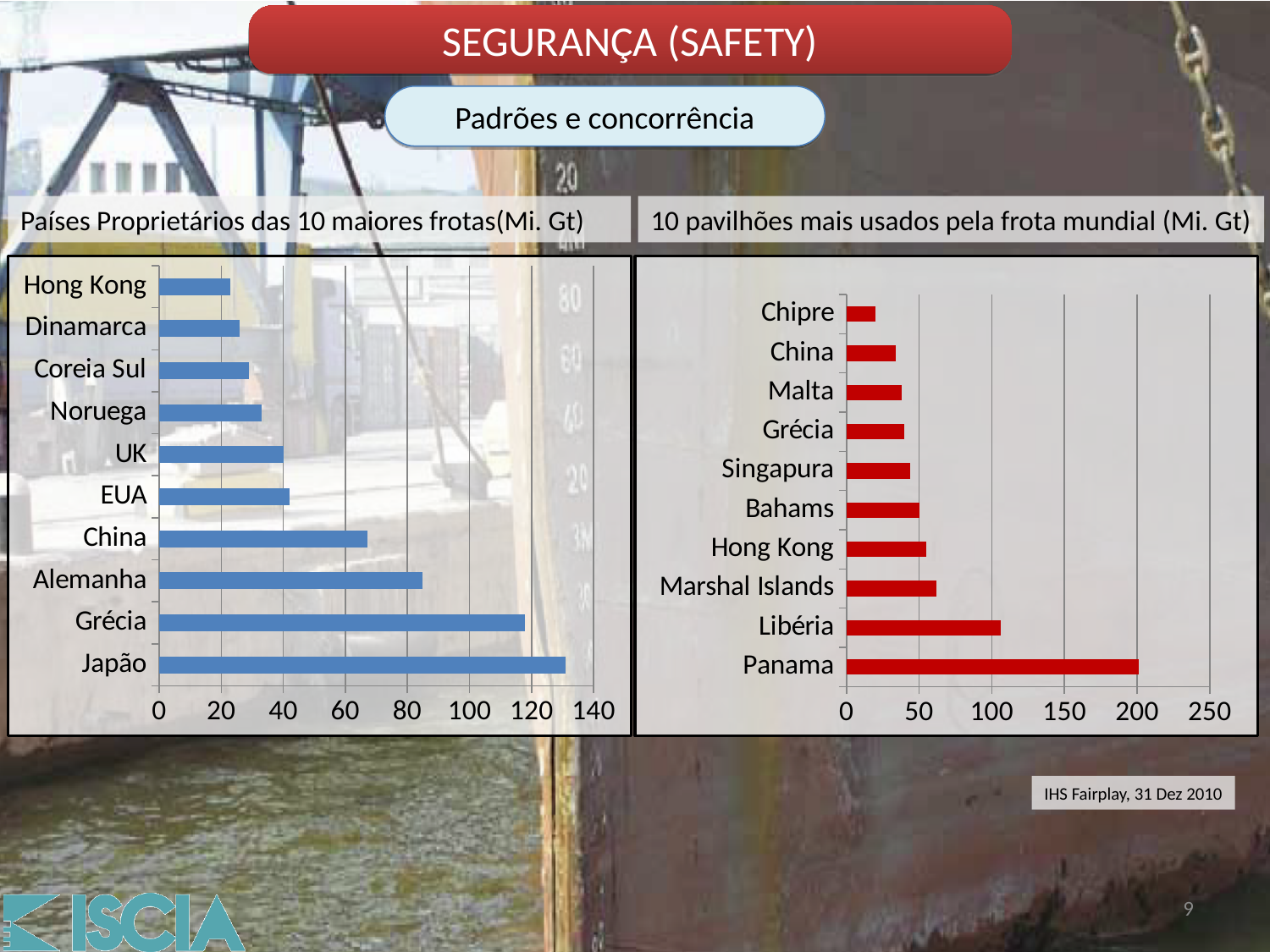
In the chart 'Países Proprietários das 10 maiores frotas(Mi. Gt)', is the value for Japão greater or less than 120? greater In the chart '10 pavilhões mais usados pela frota mundial (Mi. Gt)', which flag has the highest value? Panama In the chart 'Países Proprietários das 10 maiores frotas(Mi. Gt)', which country has the lowest value? Hong Kong In the chart 'Países Proprietários das 10 maiores frotas(Mi. Gt)', which is larger, the value for Alemanha or the value for EUA? Alemanha In the chart 'Países Proprietários das 10 maiores frotas(Mi. Gt)', is the value for China greater or less than 80? less What colour are the bars in the chart '10 pavilhões mais usados pela frota mundial (Mi. Gt)'? Red In the chart 'Países Proprietários das 10 maiores frotas(Mi. Gt)', how many countries are shown? 10 In the chart '10 pavilhões mais usados pela frota mundial (Mi. Gt)', which is larger, the value for Libéria or the value for Marshal Islands? Libéria What type of chart is 'Países Proprietários das 10 maiores frotas(Mi. Gt)'? Bar chart In the chart '10 pavilhões mais usados pela frota mundial (Mi. Gt)', which flag has the lowest value? Chipre In the chart 'Países Proprietários das 10 maiores frotas(Mi. Gt)', which country has the highest value? Japão